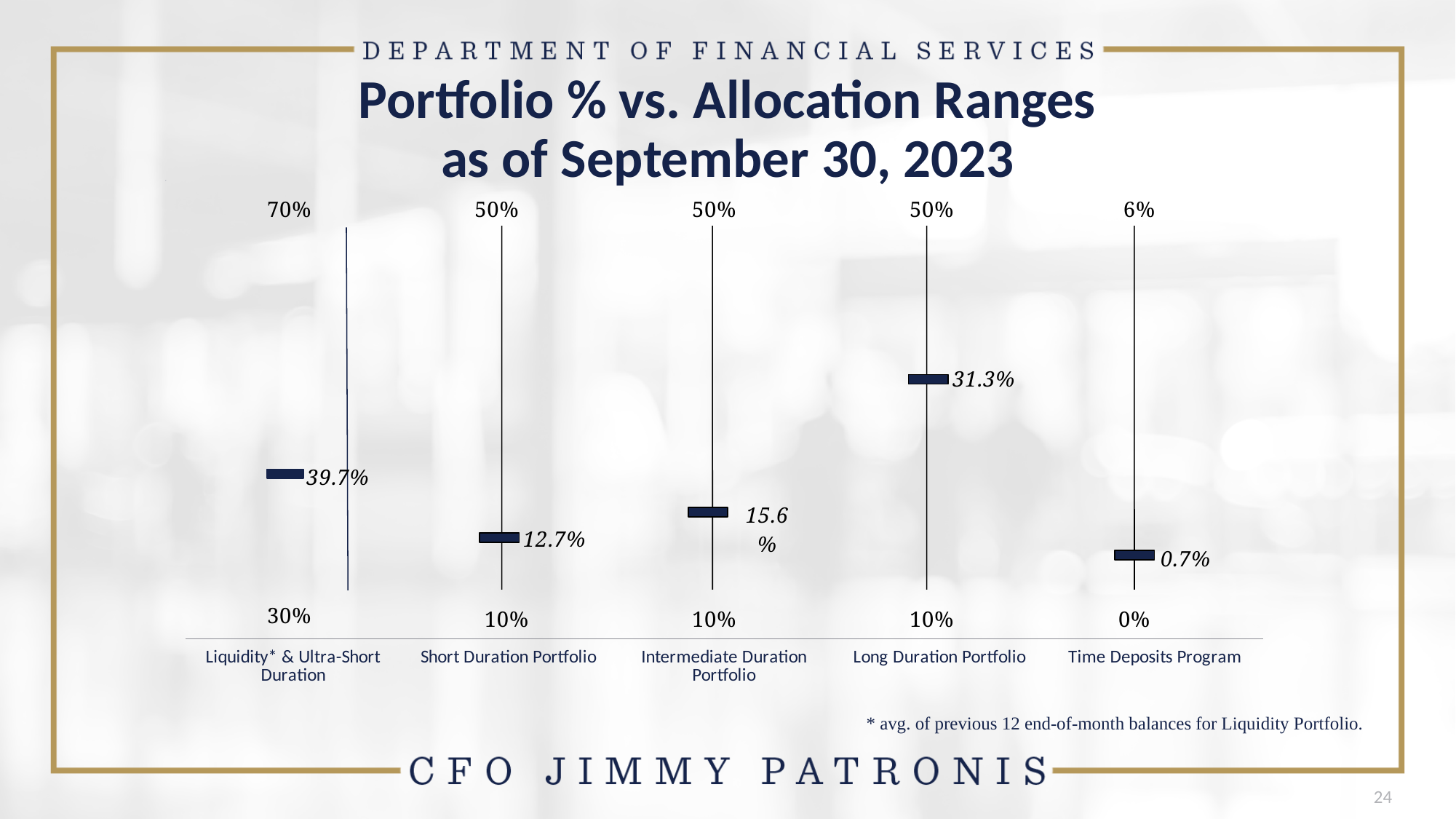
What is the portfolio % for the Short Duration Portfolio? 12.7% What is the portfolio % for the Liquidity* & Ultra-Short Duration category? 39.7% What is the title of the chart? Portfolio % vs. Allocation Ranges as of September 30, 2023 What is the portfolio % for the Long Duration Portfolio? 31.3% What is the portfolio % for the Time Deposits Program? 0.7% What is the difference between the portfolio % of the Long Duration Portfolio and the Short Duration Portfolio? 18.6% What is the portfolio % for the Intermediate Duration Portfolio? 15.6% Which category has the lowest portfolio %? Time Deposits Program What is the upper bound of the allocation range for the Time Deposits Program? 6% Which has a larger portfolio %, the Intermediate Duration Portfolio or the Short Duration Portfolio? Intermediate Duration Portfolio Which category has the highest portfolio %? Liquidity* & Ultra-Short Duration How many categories are shown on the chart? 5